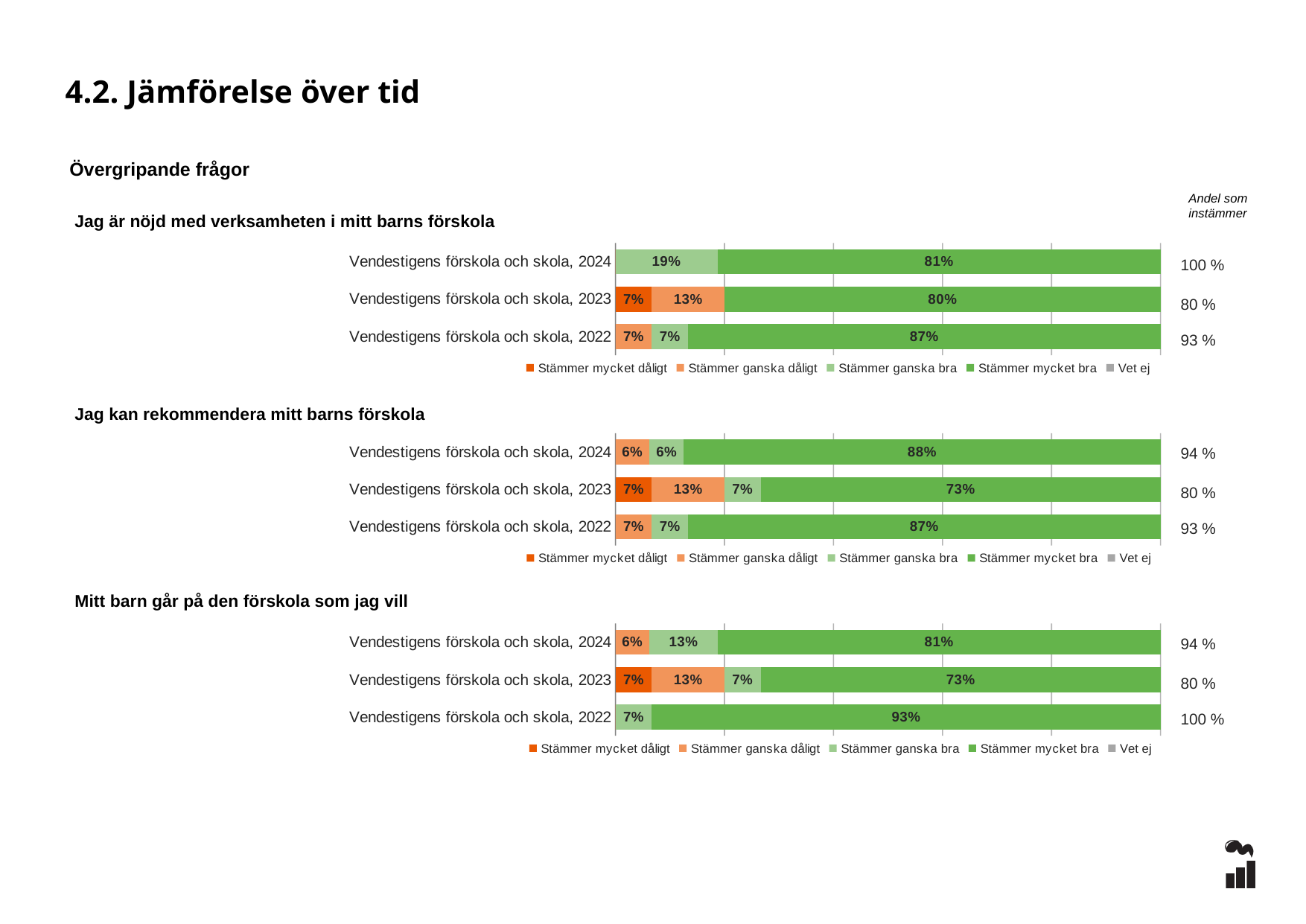
In the chart 'Jag är nöjd med verksamheten i mitt barns förskola', which year has the highest 'Stämmer mycket bra' value? 2022 In the chart 'Jag är nöjd med verksamheten i mitt barns förskola', what is the 'Stämmer ganska dåligt' value for Vendestigens förskola och skola, 2023? 13% In the chart 'Mitt barn går på den förskola som jag vill', what is the 'Stämmer mycket bra' value for Vendestigens förskola och skola, 2022? 93% How many series does the legend of the chart 'Jag är nöjd med verksamheten i mitt barns förskola' list? 5 In the chart 'Mitt barn går på den förskola som jag vill', is the 'Stämmer mycket bra' value larger for 2024 or for 2023? 2024 In the chart 'Jag kan rekommendera mitt barns förskola', what is the 'Stämmer mycket bra' value for Vendestigens förskola och skola, 2024? 88% How many bars (categories) are shown in the chart 'Jag kan rekommendera mitt barns förskola'? 3 In the chart 'Mitt barn går på den förskola som jag vill', what is the 'Andel som instämmer' shown for 2022? 100 % What kind of chart is 'Mitt barn går på den förskola som jag vill'? Stacked bar chart In the chart 'Jag kan rekommendera mitt barns förskola', what is the difference between the 'Stämmer mycket bra' values for 2024 and 2023? 15% In the chart 'Jag kan rekommendera mitt barns förskola', which year has the lowest 'Stämmer mycket bra' value? 2023 In the chart 'Jag är nöjd med verksamheten i mitt barns förskola', what is the 'Stämmer mycket bra' value for Vendestigens förskola och skola, 2024? 81%